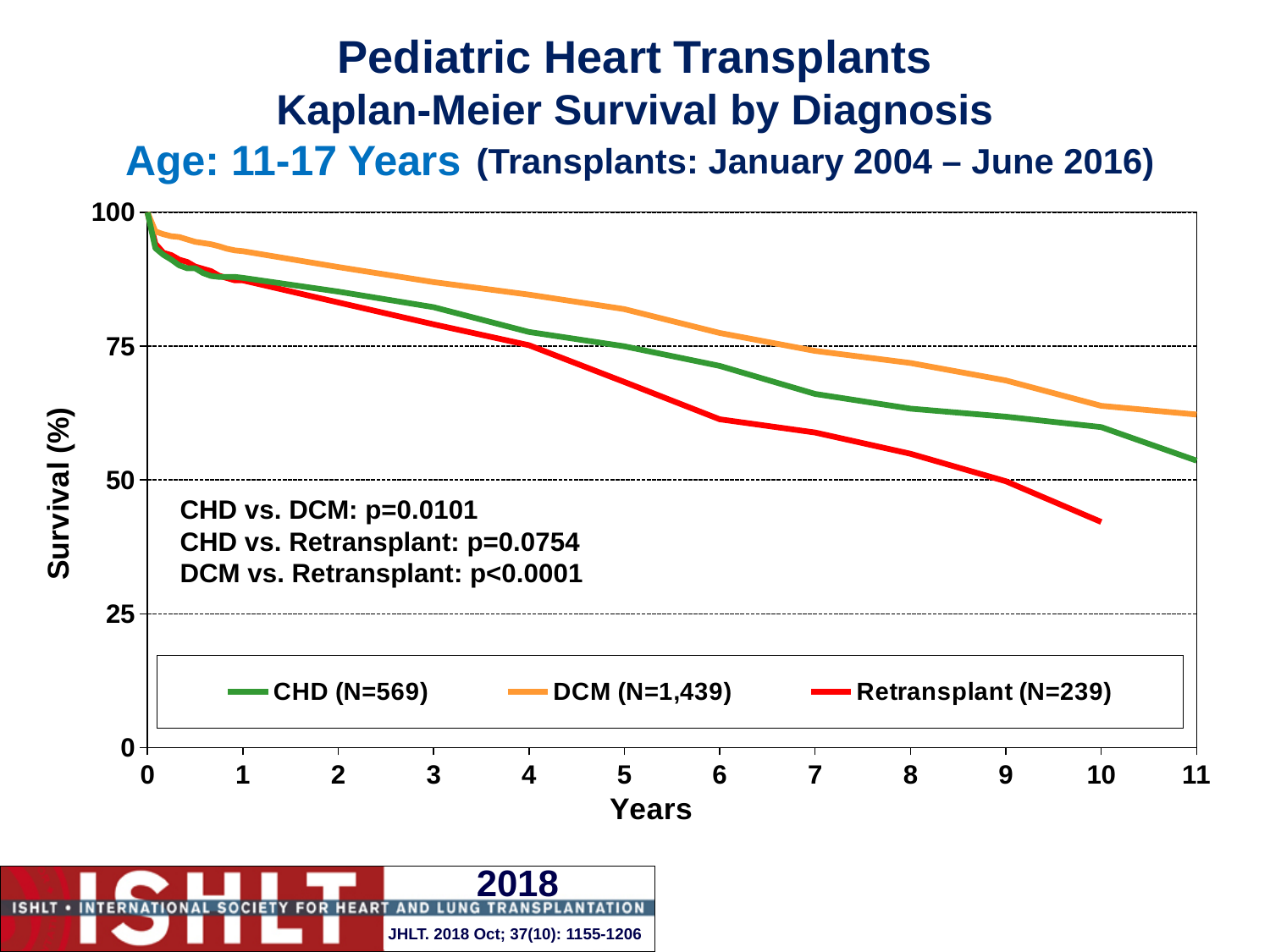
Is the survival value for DCM at year 2 greater or less than 75? greater Is the survival value for Retransplant at year 10 greater or less than 50? less Which series has the lowest survival at year 9? Retransplant At year 10, which series has higher survival, CHD or Retransplant? CHD Is the survival value for DCM at year 5 greater or less than 75? greater What kind of chart is shown on the slide? line chart Does the survival for the DCM series rise or fall as years increase? fall At year 8, which series has higher survival, DCM or Retransplant? DCM How many series does the legend list? 3 Which series has the highest survival at year 9? DCM What is the N shown in the legend for the DCM series? 1,439